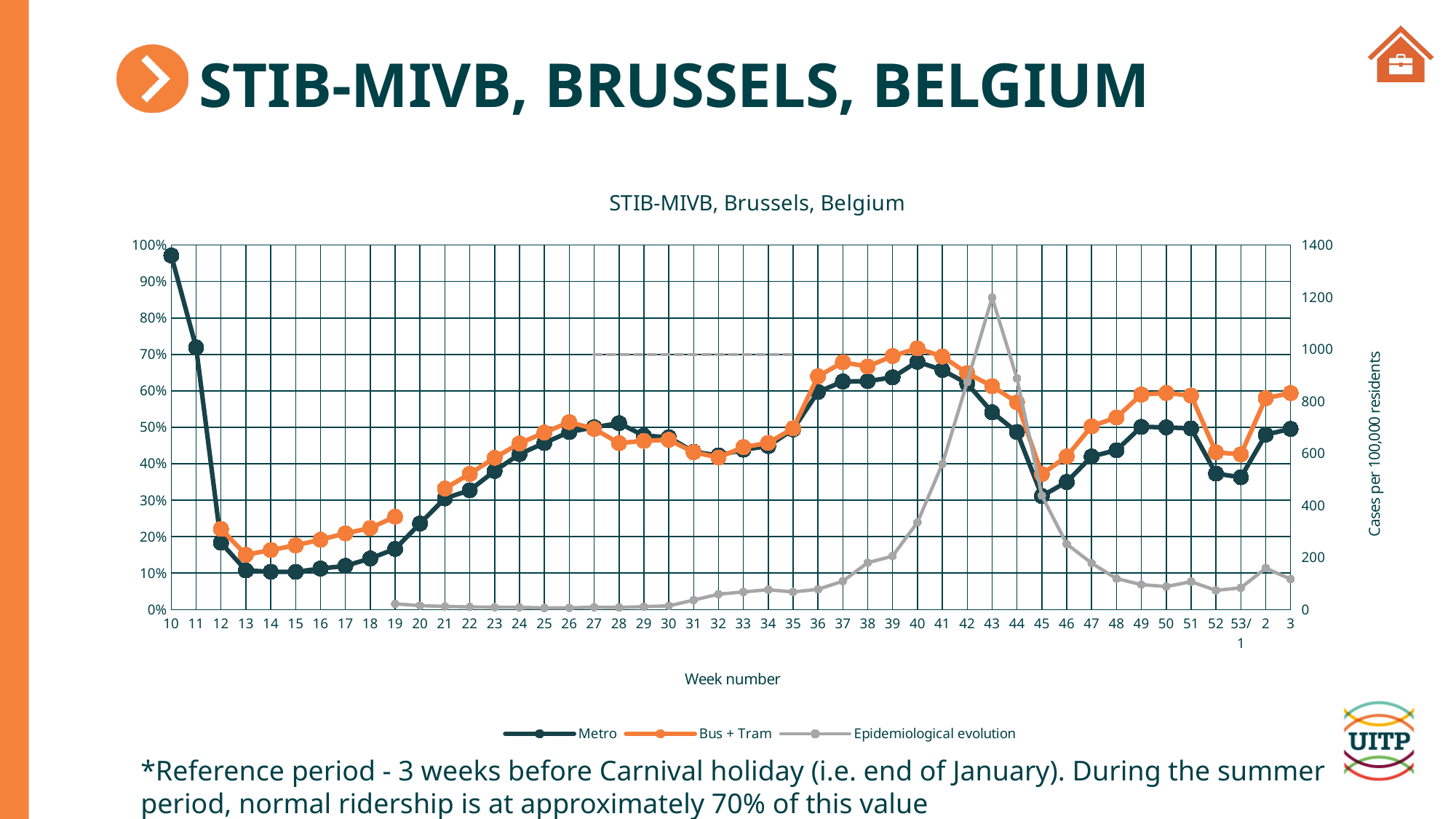
Is the Epidemiological evolution value at week 43 greater or less than 1000? greater What is the title of the right-hand vertical axis? Cases per 100,000 residents At week 45, which is larger: Metro or Bus + Tram? Bus + Tram Is the Metro value at week 10 greater or less than 90%? greater Does the Metro series rise or fall between week 10 and week 13? Fall Is the Bus + Tram value at week 40 greater or less than 60%? greater What are the three series listed in the legend? Metro, Bus + Tram, Epidemiological evolution At which week does the Metro series reach its highest value? 10 At which week does the Epidemiological evolution series reach its highest value? 43 How many series does the legend list? 3 What kind of chart is shown on the slide? Line chart